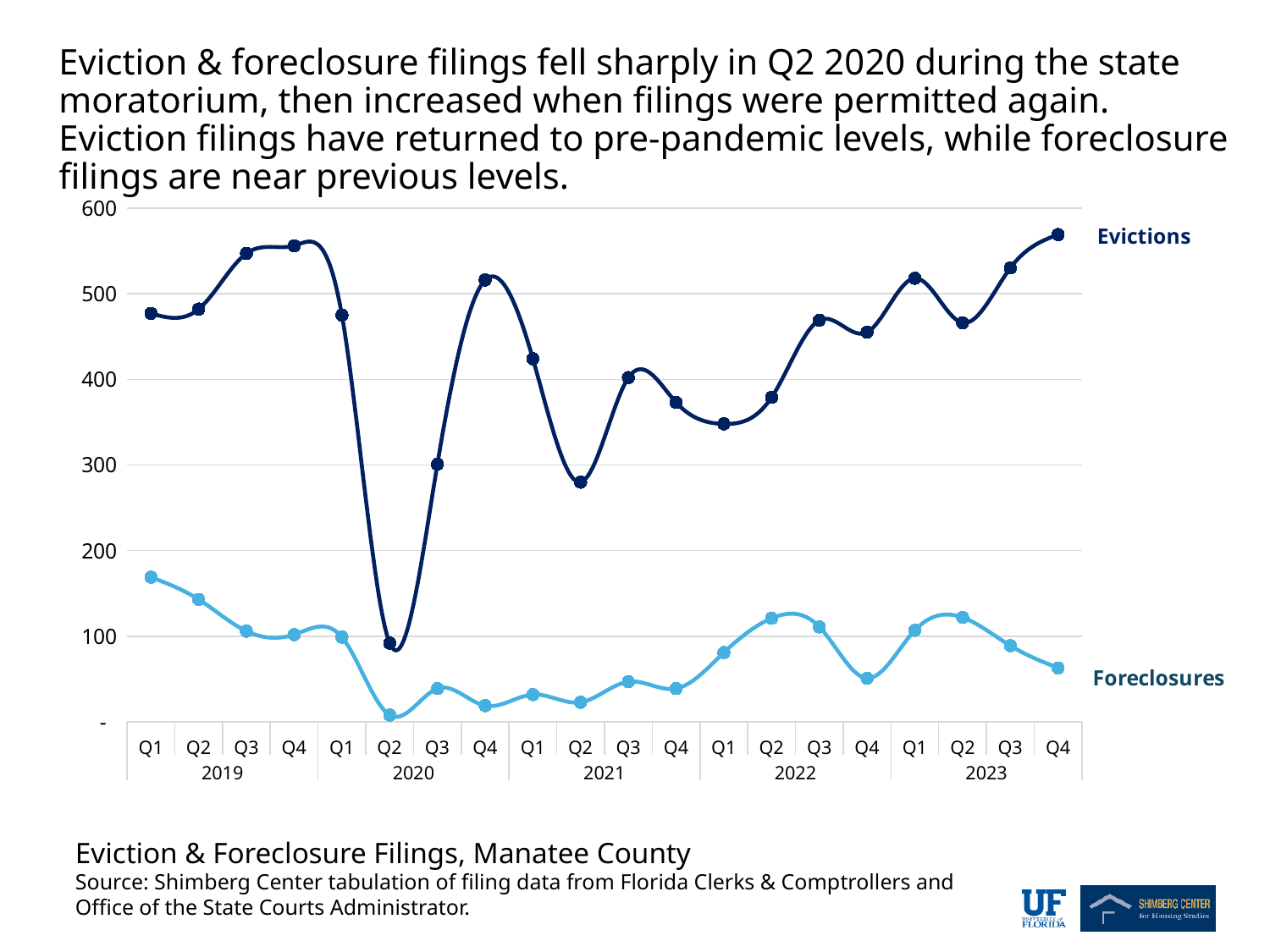
Do Foreclosures rise or fall from Q1 2019 to Q3 2019? Fall Is the value for Evictions in Q4 2020 greater or less than 500? greater In which quarter is the Evictions line at its lowest? Q2 2020 What is the title of the chart? Eviction & Foreclosure Filings, Manatee County Is the value for Evictions in Q2 2020 greater or less than 100? less How many quarterly data points does each line have? 20 What kind of chart is shown on the slide? Line chart How many series are plotted on the chart? 2 Is the value for Foreclosures in Q2 2022 greater or less than 100? greater In which quarter is the Foreclosures line at its lowest? Q2 2020 In which quarter is the Foreclosures line at its highest? Q1 2019 Which is larger, Evictions in Q1 2019 or Evictions in Q3 2019? Q3 2019